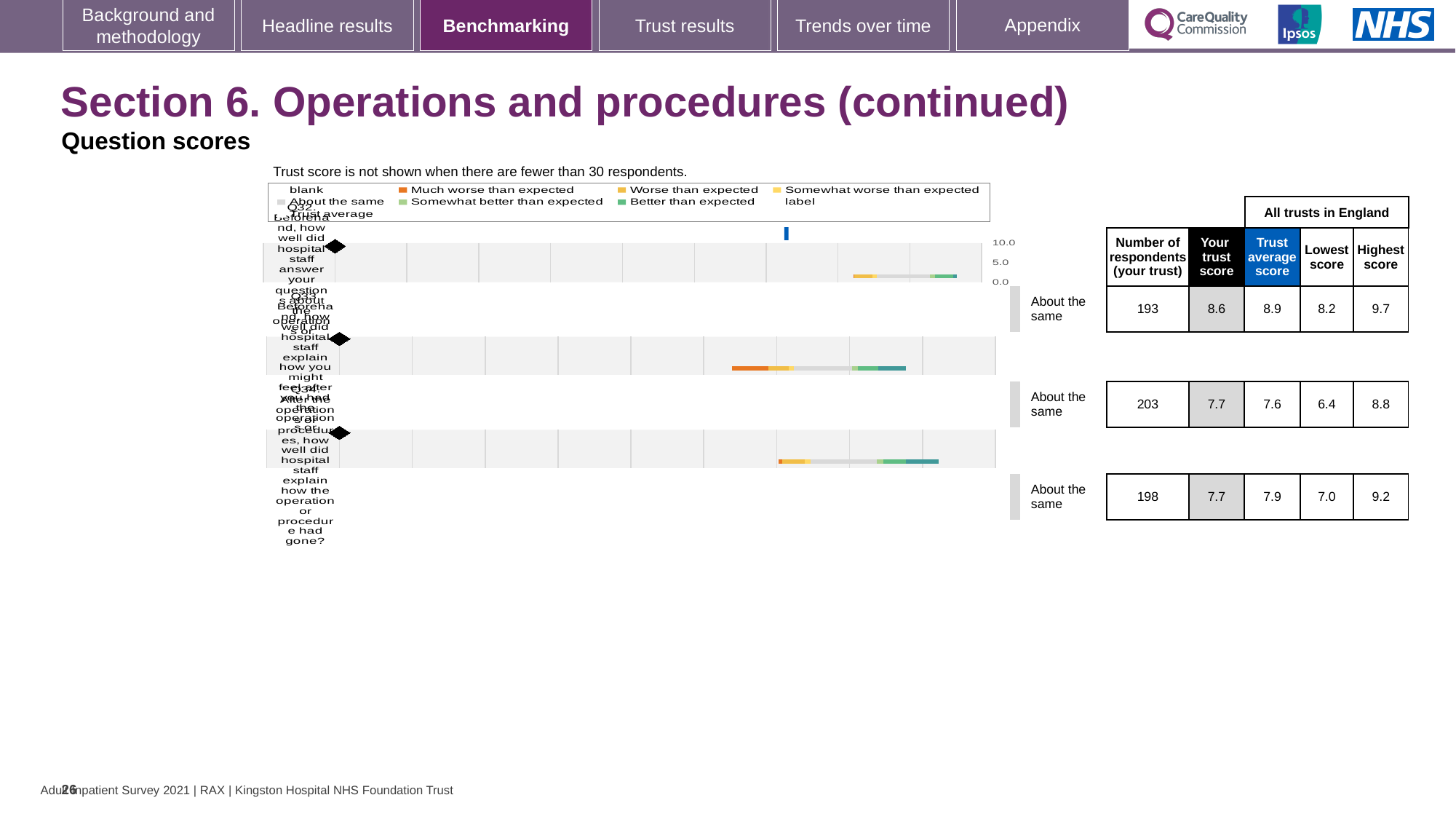
Which question row has the highest 'Your trust score'? the first (top) row What is the highest score across all trusts in England for the first (top) question row? 9.7 What is the lowest score across all trusts in England for the second question row? 6.4 What is the trust average score for the second question row? 7.6 What kind of chart is used to show the question scores on this slide? bar chart How many question rows are plotted in the benchmarking chart? 3 What is the difference between the highest score and the lowest score for the third question row? 2.2 For the second question row, which is larger: the 'Your trust score' or the trust average score? Your trust score What is the 'Your trust score' for the first (top) question row? 8.6 What is the maximum value shown on the chart's score axis? 10.0 What is the number of respondents for the first (top) question row? 193 What benchmark rating is shown next to each of the three question rows? About the same